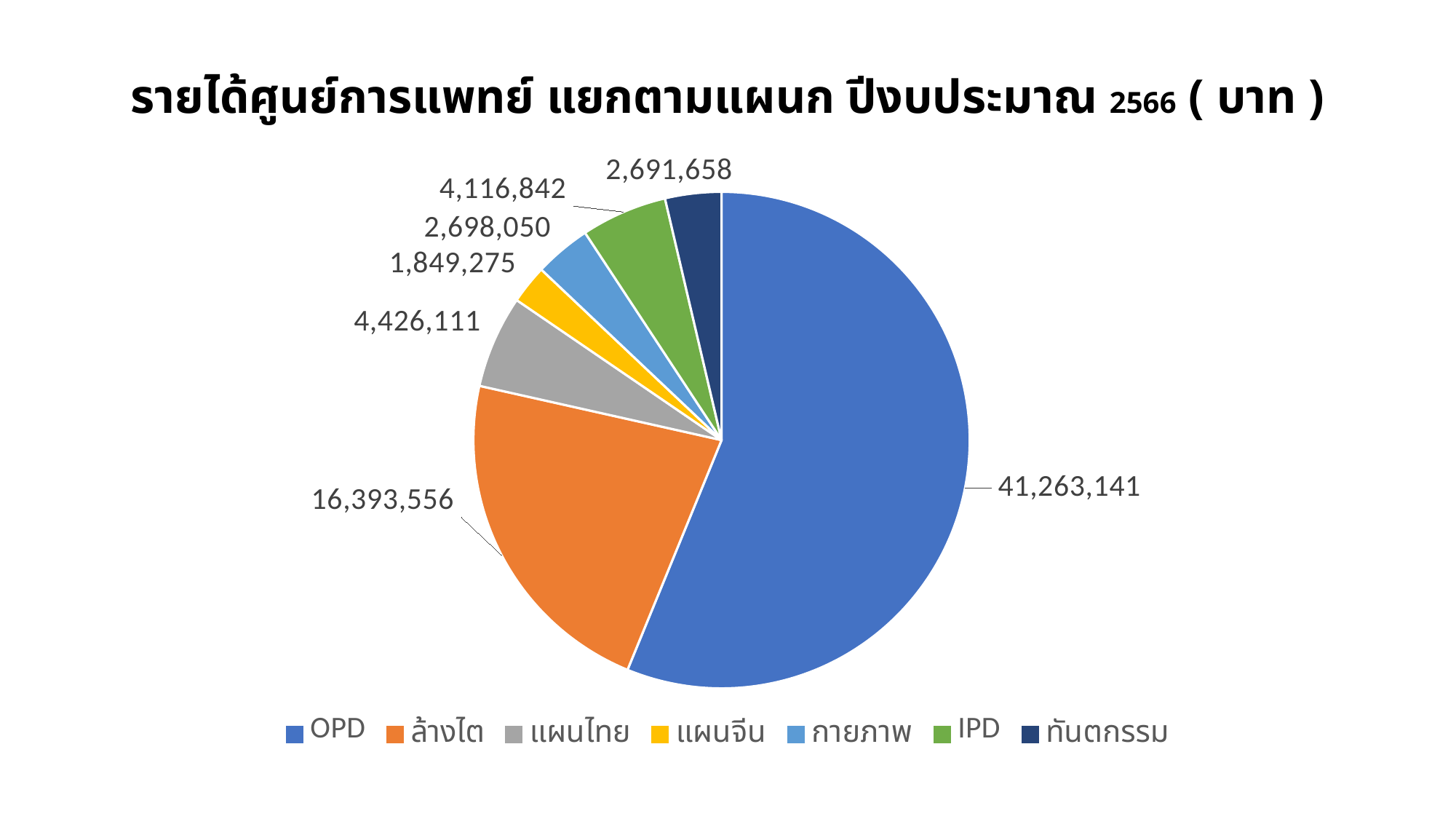
What is the value for OPD in the pie chart? 41,263,141 What kind of chart is shown on the slide? Pie chart What is the difference between the values for OPD and ล้างไต? 24,869,585 How many departments are shown in the pie chart? 7 What is the value for IPD in the pie chart? 4,116,842 Which department has the smallest slice of the pie chart? แผนจีน What is the value for ล้างไต in the pie chart? 16,393,556 What colour is the slice for ล้างไต? Orange What is the difference between the values for แผนไทย and IPD? 309,269 Which department has the largest slice of the pie chart? OPD Which is larger, the value for แผนไทย or the value for กายภาพ? แผนไทย What is the value for แผนจีน in the pie chart? 1,849,275